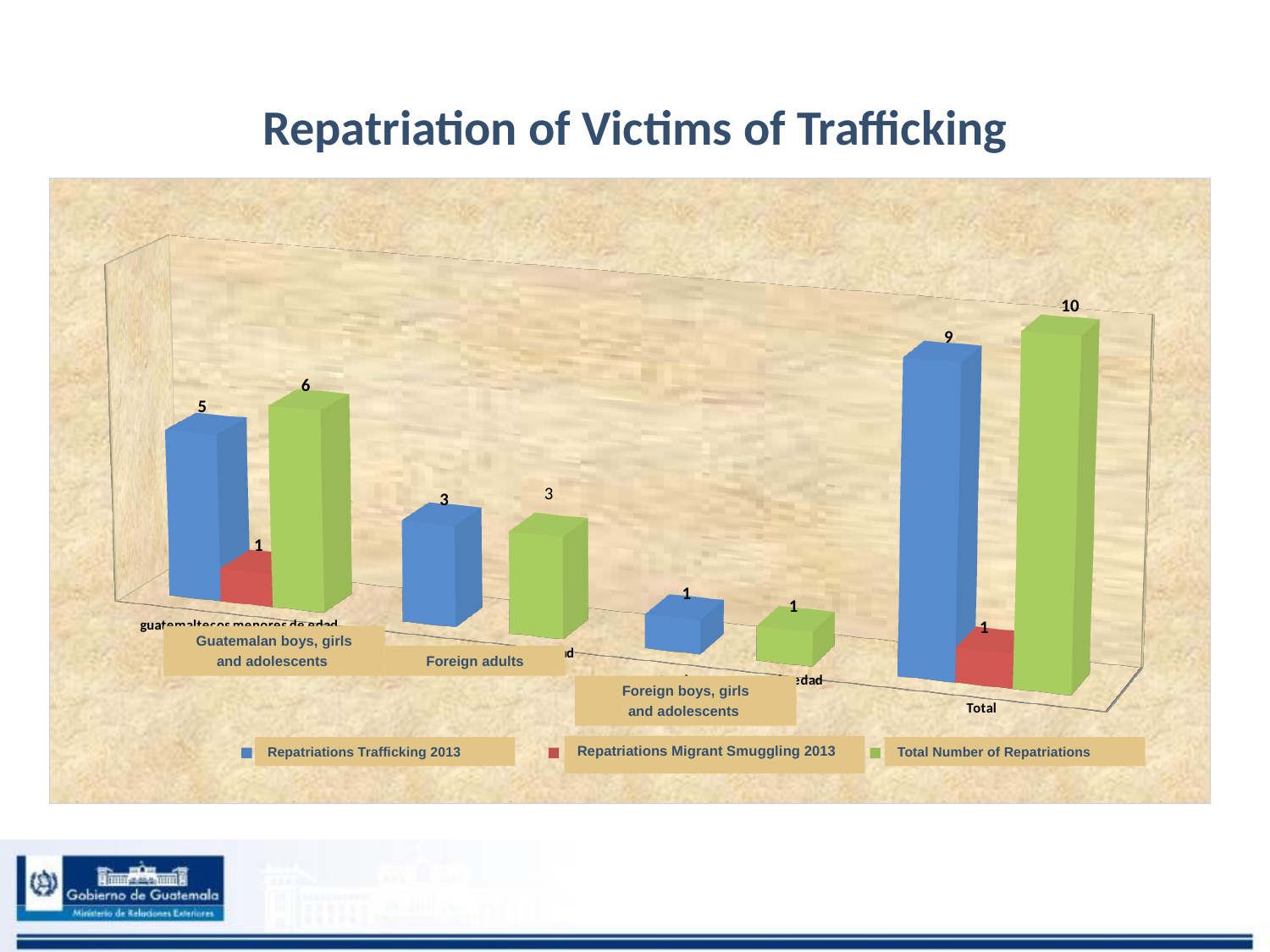
How many categories are shown on the x axis of the chart? 4 What is the Total Number of Repatriations for Foreign adults? 3 Excluding the Total category, which category has the lowest Total Number of Repatriations? Foreign boys, girls and adolescents What is the value of Repatriations Migrant Smuggling 2013 for the Total category? 1 What kind of chart is shown on the slide? Bar chart What is the title of the slide? Repatriation of Victims of Trafficking Which category has the highest value for Repatriations Trafficking 2013? Total What is the value of Repatriations Trafficking 2013 for Guatemalan boys, girls and adolescents? 5 What is the Total Number of Repatriations for the Total category? 10 How many series does the legend list? 3 What is the difference between the Total Number of Repatriations and Repatriations Trafficking 2013 for the Total category? 1 Which is larger for Guatemalan boys, girls and adolescents: Repatriations Trafficking 2013 or Repatriations Migrant Smuggling 2013? Repatriations Trafficking 2013